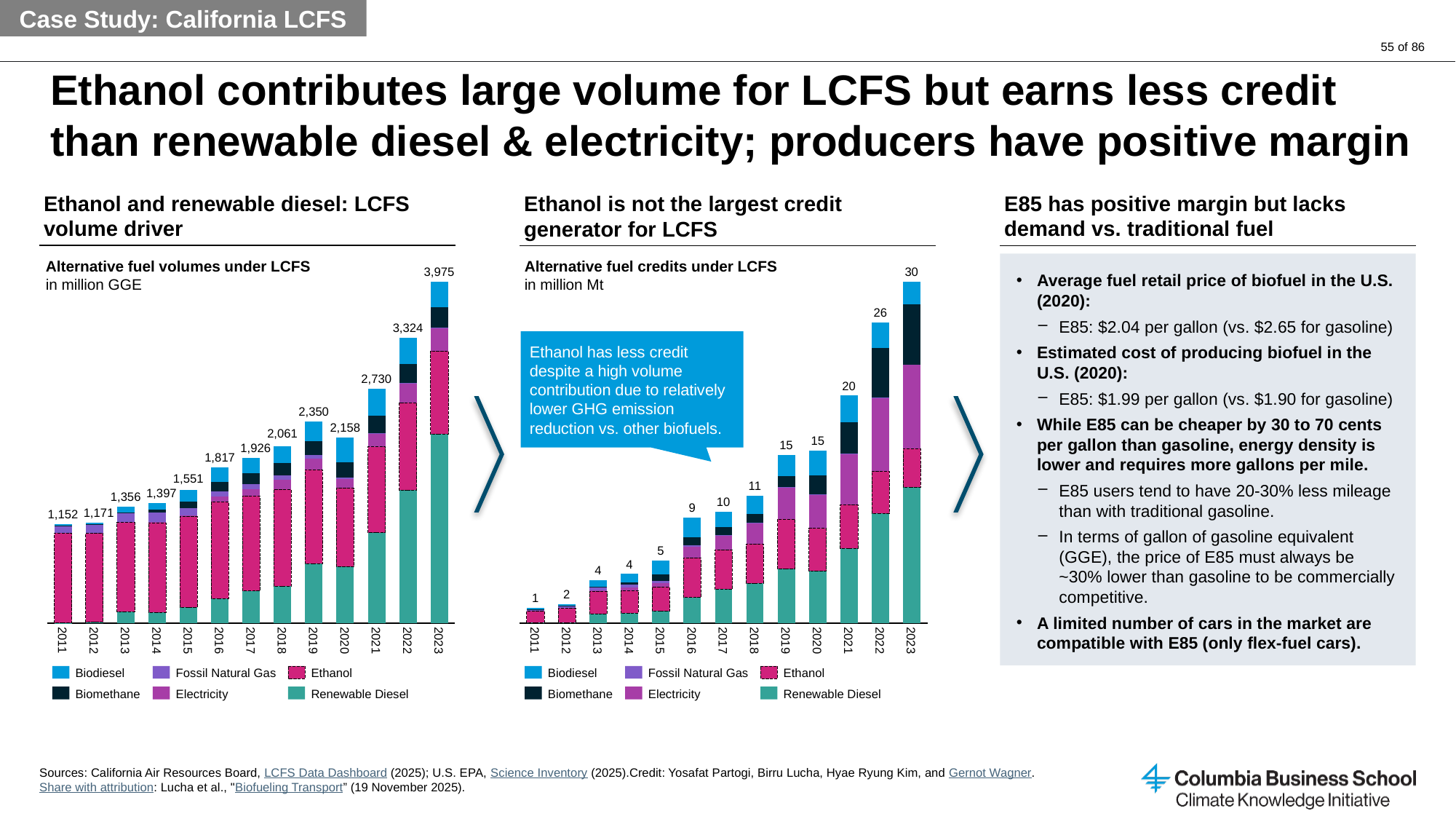
How many series does the legend of the 'Alternative fuel volumes under LCFS' chart list? 6 In the 'Alternative fuel credits under LCFS' chart, which year has the highest total credits? 2023 In the 'Alternative fuel volumes under LCFS' chart, what is the total volume labeled for 2020? 2,158 In the 'Alternative fuel credits under LCFS' chart, what unit is given for the values? million Mt In the 'Alternative fuel credits under LCFS' chart, what is the total credit value labeled for 2022? 26 In the 'Alternative fuel volumes under LCFS' chart, what is the total volume labeled for 2023? 3,975 How many years are shown on the x axis of the 'Alternative fuel credits under LCFS' chart? 13 In the 'Alternative fuel volumes under LCFS' chart, which year has the larger total, 2019 or 2020? 2019 In the 'Alternative fuel volumes under LCFS' chart, which year has the lowest total volume? 2011 In the 'Alternative fuel volumes under LCFS' chart, what is the difference between the 2023 total and the 2022 total? 651 In the 'Alternative fuel credits under LCFS' chart, what is the difference between the 2021 total and the 2019 total? 5 What kind of chart is the 'Alternative fuel credits under LCFS' chart? Stacked bar chart